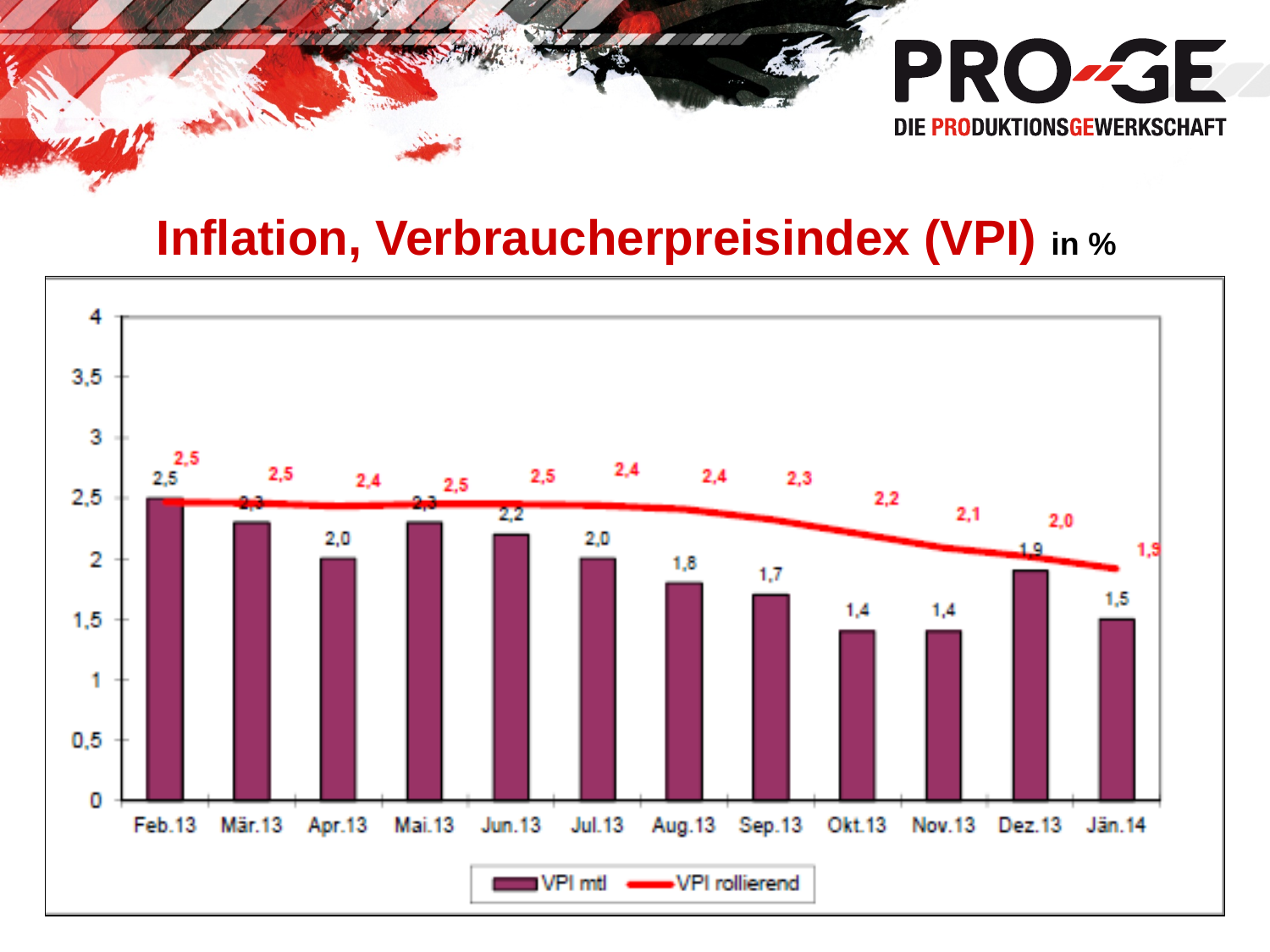
Which month has the lowest VPI rollierend value? Jän.14 Is the VPI mtl value for Aug.13 greater or less than 2? less Which month has the highest VPI mtl value? Feb.13 How many series does the legend list? 2 What is the difference between the VPI mtl values for Feb.13 and Jän.14? 1,0 What is the VPI rollierend value for Okt.13? 2,2 What is the VPI mtl value for Sep.13? 1,7 Which has the larger VPI mtl value, Dez.13 or Jän.14? Dez.13 Do the VPI rollierend values generally rise or fall from Feb.13 to Jän.14? fall How many months are shown on the x axis? 12 What is the VPI mtl value for Feb.13? 2,5 What is the VPI rollierend value for Jän.14? 1,9